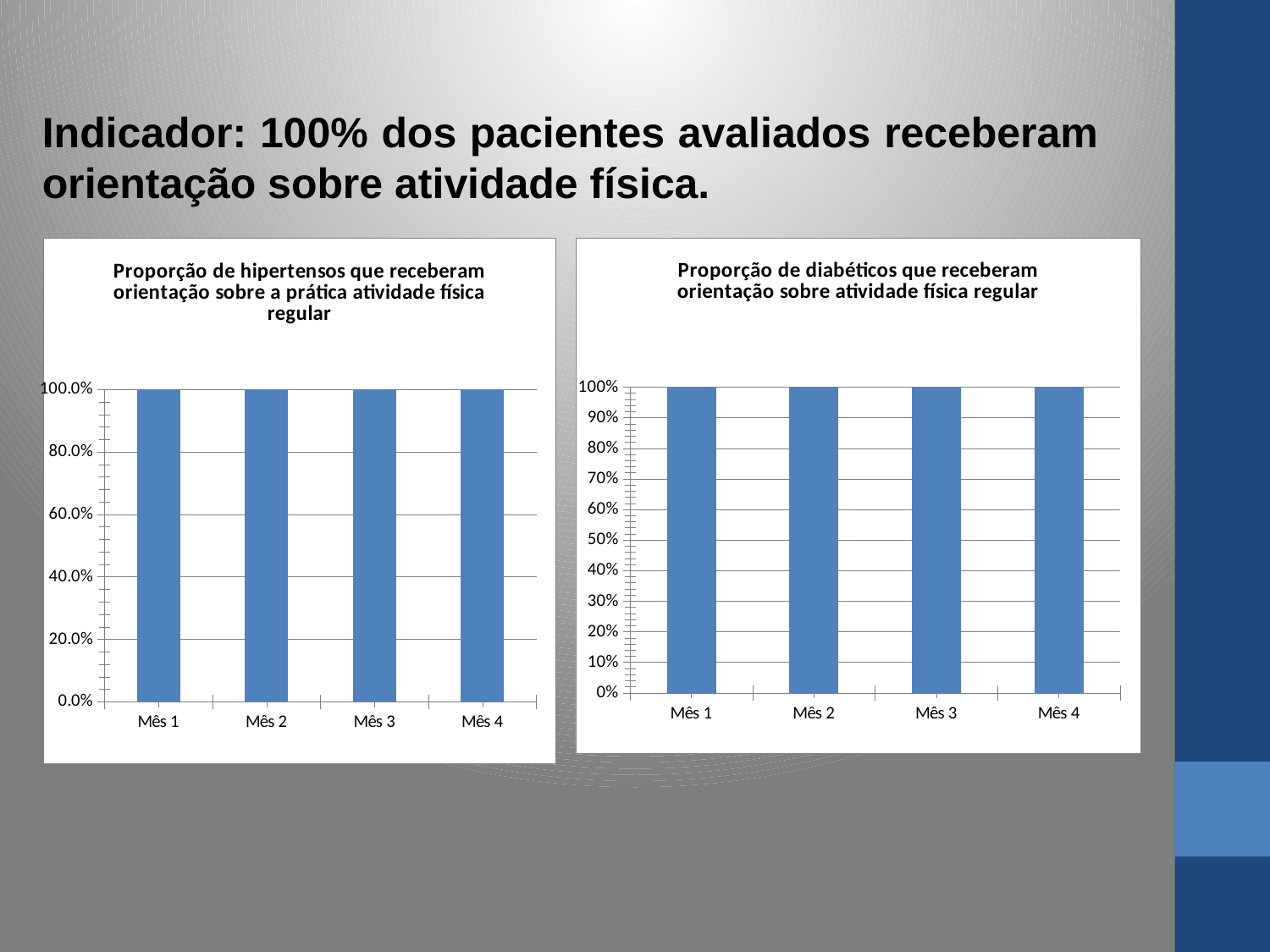
What kind of chart is the right chart (Proporção de diabéticos)? Bar chart In the left chart (Proporção de hipertensos), what is the value for Mês 1? 100.0% In the left chart (Proporção de hipertensos), is the value for Mês 2 greater or less than 80.0%? greater How many bars are plotted in the right chart (Proporção de diabéticos)? 4 How many categories (months) are shown in the left chart (Proporção de hipertensos)? 4 In the right chart (Proporção de diabéticos), is the value for Mês 4 greater or less than 50%? greater In the right chart (Proporção de diabéticos), what is the value for Mês 3? 100% In the right chart (Proporção de diabéticos), do the values rise, fall or stay the same from Mês 1 to Mês 4? Stay the same In the left chart (Proporção de hipertensos), what is the value for Mês 4? 100.0% In the right chart (Proporção de diabéticos), what is the value for Mês 2? 100% What is the title of the right chart? Proporção de diabéticos que receberam orientação sobre atividade física regular What kind of chart is the left chart (Proporção de hipertensos)? Bar chart